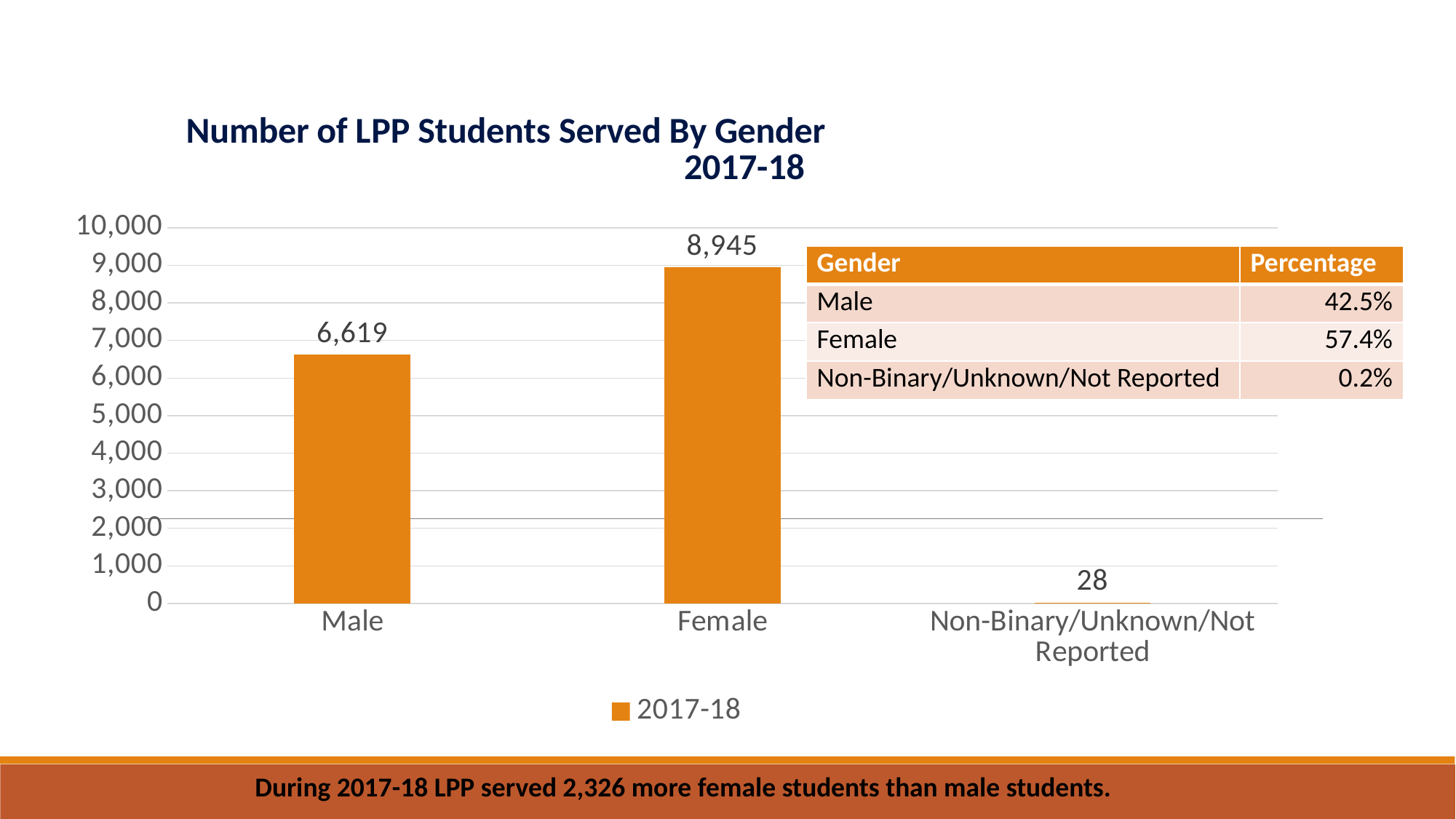
What is the number of LPP students served for Female in 2017-18? 8,945 What is the number of LPP students served for Non-Binary/Unknown/Not Reported in 2017-18? 28 How many gender categories are shown on the x axis? 3 What is the title of the chart? Number of LPP Students Served By Gender 2017-18 What is the difference between the number of Female and Male students served? 2,326 What is the number of LPP students served for Male in 2017-18? 6,619 Which gender category has the lowest number of LPP students served? Non-Binary/Unknown/Not Reported What kind of chart is shown on the slide? bar chart How many series does the legend list? 1 Which gender category has the highest number of LPP students served? Female Which is larger, the number of Male students or the number of Female students served? Female Is the value for Male greater or less than 7,000? less